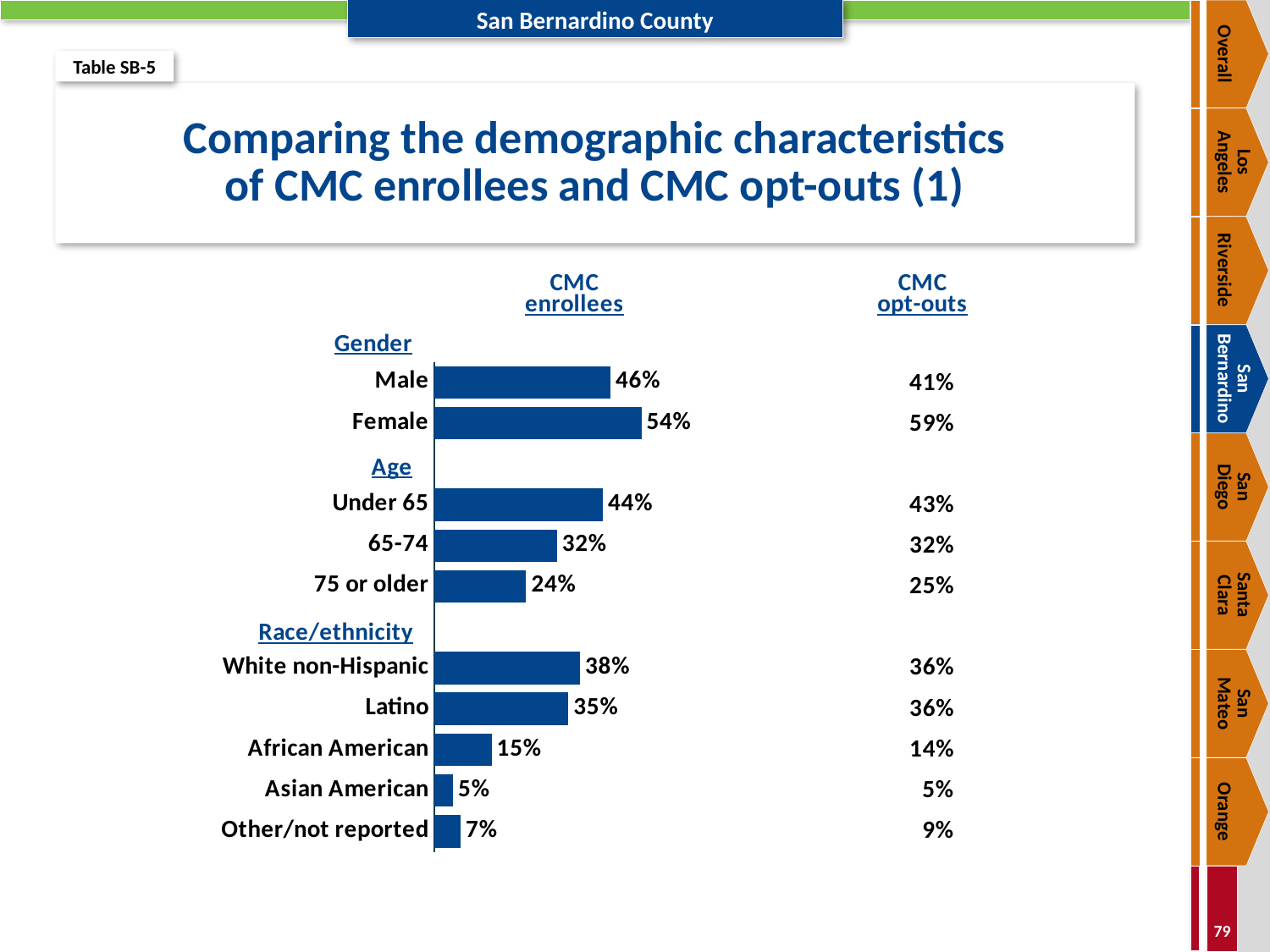
What is the title of the slide containing the chart? Comparing the demographic characteristics of CMC enrollees and CMC opt-outs (1) What is the difference between the Female and Male percentages for CMC enrollees? 8% What kind of chart is used to show the CMC enrollees percentages? Bar chart What percentage of CMC enrollees are Female? 54% What percentage of CMC enrollees are African American? 15% What percentage of CMC opt-outs are Latino? 36% Which is larger for CMC enrollees, the Under 65 share or the 65-74 share? Under 65 Which race/ethnicity category has the highest share of CMC enrollees? White non-Hispanic How many bars are plotted in the CMC enrollees chart? 10 Which race/ethnicity category has the lowest share of CMC enrollees? Asian American What percentage of CMC enrollees are 75 or older? 24% Which is larger, the Other/not reported share for CMC enrollees or for CMC opt-outs? CMC opt-outs